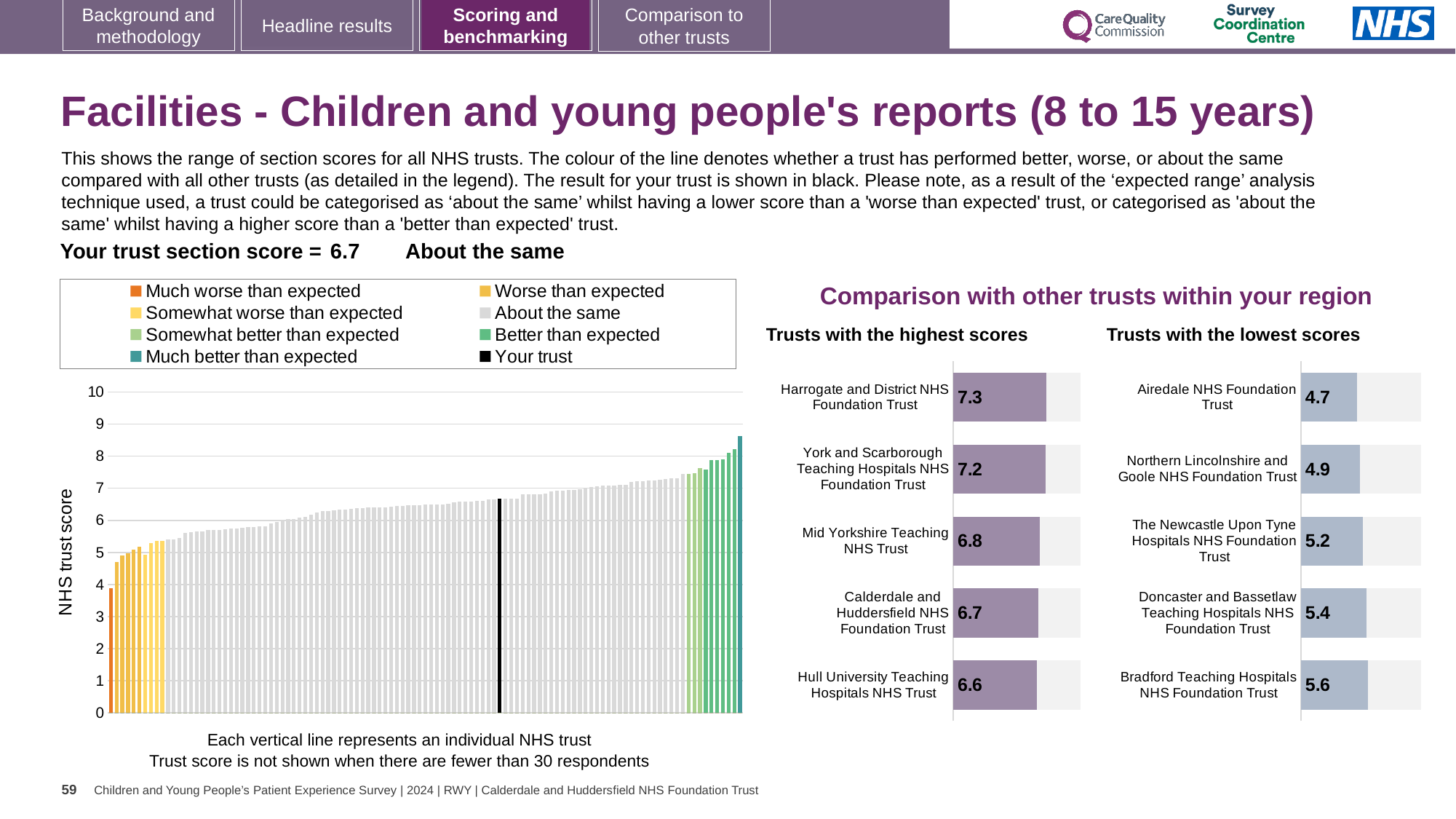
In the 'Trusts with the lowest scores' chart, which trust has the lowest score? Airedale NHS Foundation Trust In the 'Trusts with the highest scores' chart, which trust has the highest score? Harrogate and District NHS Foundation Trust What kind of chart is the NHS trust score chart on the left of the slide? Bar chart In the NHS trust score chart on the left, do the trust scores rise or fall from left to right? Rise In the NHS trust score chart on the left, is the value of the tallest bar greater or less than 8? greater How many entries does the legend of the NHS trust score chart on the left list? 8 Comparing the regional charts, which has the higher score: Mid Yorkshire Teaching NHS Trust or Doncaster and Bassetlaw Teaching Hospitals NHS Foundation Trust? Mid Yorkshire Teaching NHS Trust How many trusts are listed in the 'Trusts with the highest scores' chart? 5 In the 'Trusts with the highest scores' chart, what is the difference between the scores of Harrogate and District NHS Foundation Trust and Hull University Teaching Hospitals NHS Trust? 0.7 In the 'Trusts with the lowest scores' chart, what is the difference between the scores of Bradford Teaching Hospitals NHS Foundation Trust and Airedale NHS Foundation Trust? 0.9 In the 'Trusts with the lowest scores' chart, what is the score for Airedale NHS Foundation Trust? 4.7 In the 'Trusts with the highest scores' chart, what is the score for Harrogate and District NHS Foundation Trust? 7.3